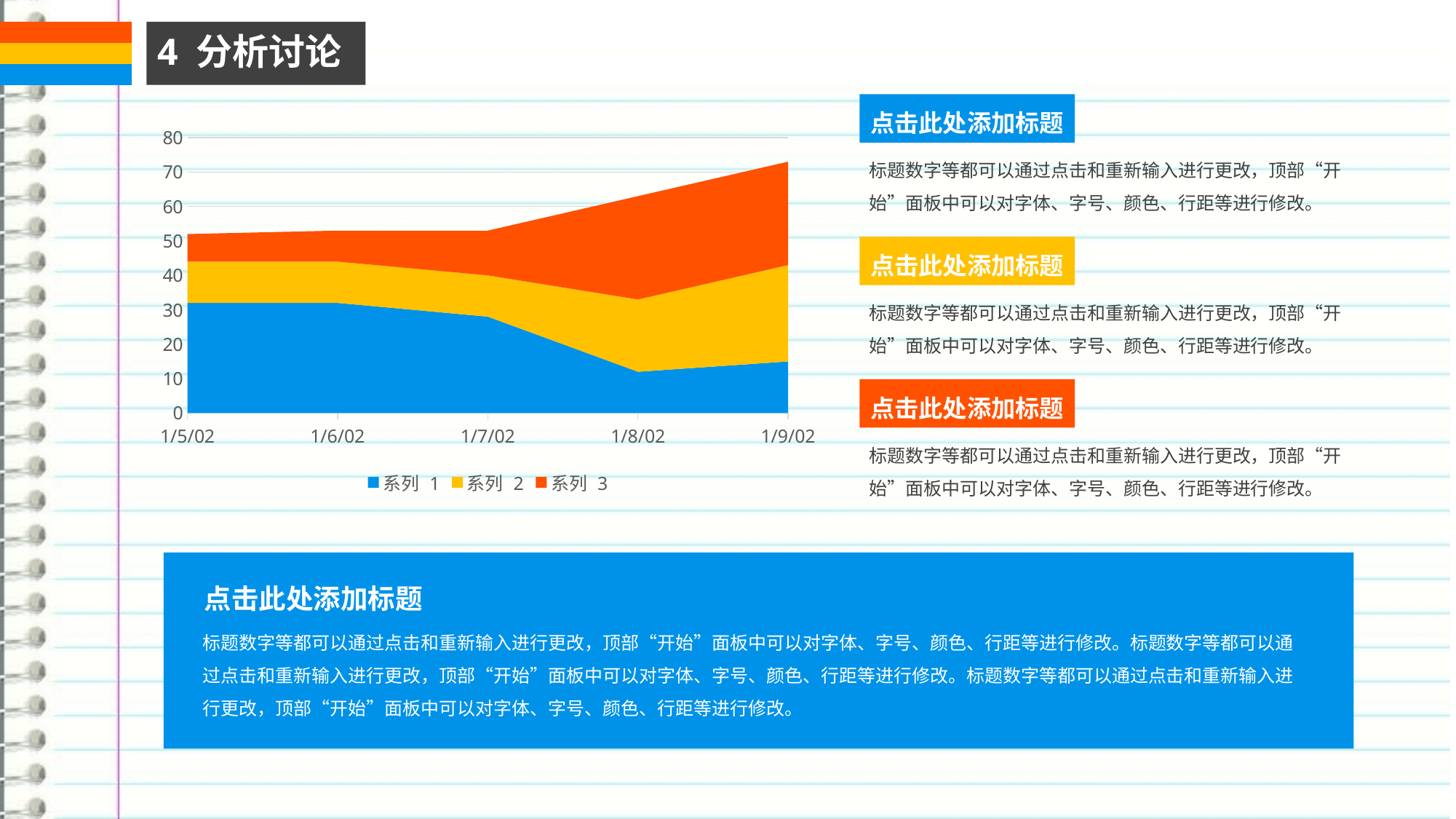
How many dates are shown along the x axis of the chart? 5 Does the stacked total of all series rise or fall from 1/7/02 to 1/9/02? rise Is the value for 系列 1 at 1/8/02 greater or less than 20? less What is the first date label on the x axis of the chart? 1/5/02 Is the value for 系列 1 at 1/5/02 greater or less than 20? greater Which series is shown in blue in the chart? 系列 1 How many series does the chart legend list? 3 Is the stacked total of all series at 1/5/02 greater or less than 60? less At which date is the stacked total of all series highest? 1/9/02 Does the value for 系列 1 rise or fall from 1/5/02 to 1/8/02? fall What kind of chart is shown on the slide? Stacked area chart